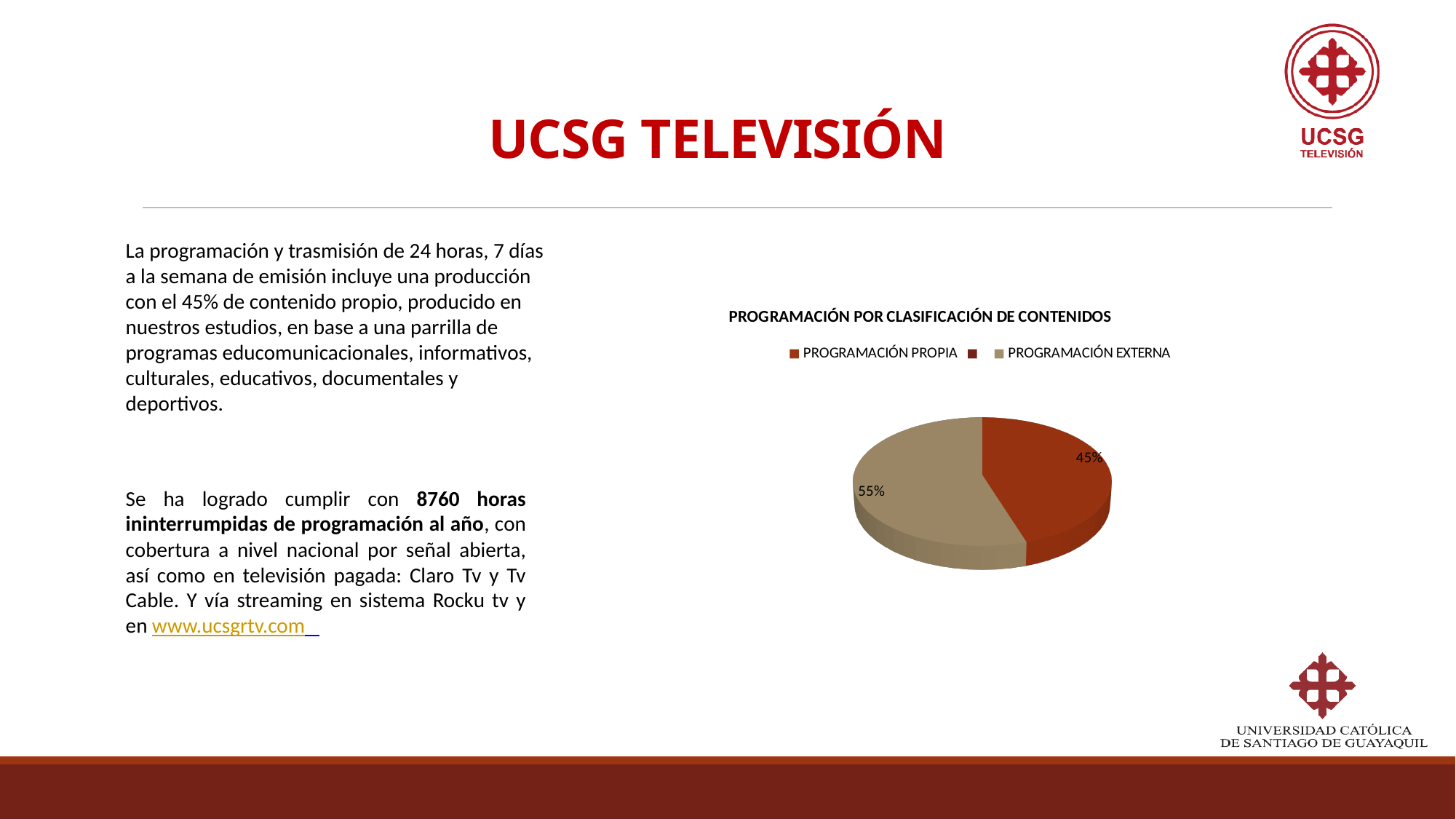
What is the difference in percentage points between PROGRAMACIÓN EXTERNA and PROGRAMACIÓN PROPIA? 10 percentage points Is the share for PROGRAMACIÓN EXTERNA greater or less than 50%? greater What is the title of the chart? PROGRAMACIÓN POR CLASIFICACIÓN DE CONTENIDOS Which slice of the pie is the largest? PROGRAMACIÓN EXTERNA How many slices does the pie chart have? 2 Which is larger, PROGRAMACIÓN PROPIA or PROGRAMACIÓN EXTERNA? PROGRAMACIÓN EXTERNA What colour is the PROGRAMACIÓN PROPIA slice? red What kind of chart is shown on the slide? pie chart What share of the pie does PROGRAMACIÓN EXTERNA represent? 55% Which slice of the pie is the smallest? PROGRAMACIÓN PROPIA Is the share for PROGRAMACIÓN PROPIA greater or less than 50%? less What share of the pie does PROGRAMACIÓN PROPIA represent? 45%